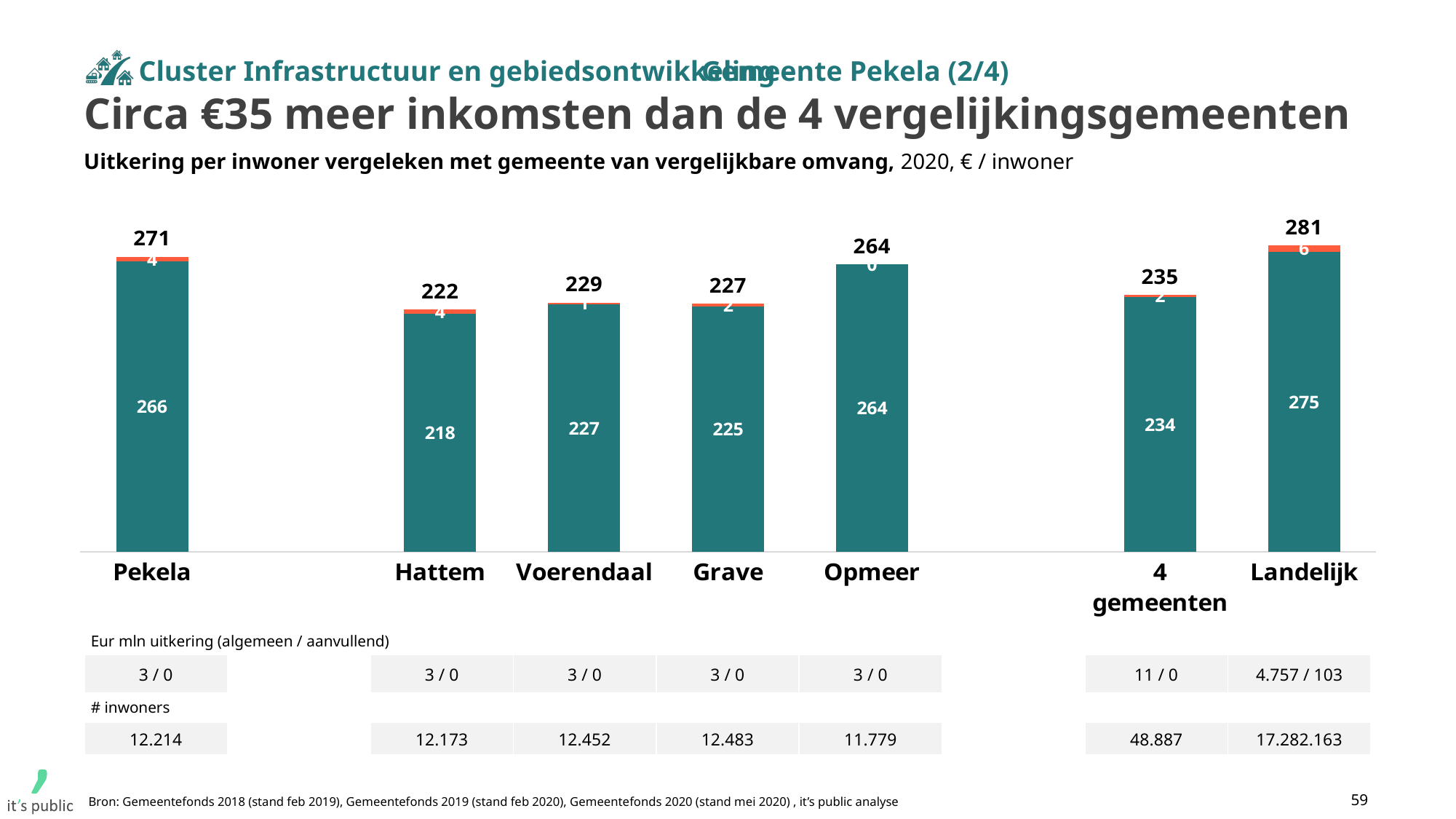
Which category has the lowest total bar? Hattem Which category has the highest total bar? Landelijk What is the total value of the bar for Pekela? 271 What kind of chart is shown on the slide? Stacked bar chart Which is larger, the total for Voerendaal or the total for Grave? Voerendaal What is the value of the orange (upper) segment for Landelijk? 6 What is the difference between the total for Pekela and the total for 4 gemeenten? 36 How many categories are shown on the x axis of the chart? 7 What is the subtitle of the chart? Uitkering per inwoner vergeleken met gemeente van vergelijkbare omvang, 2020, € / inwoner What is the total value of the bar for Landelijk? 281 What is the value of the teal (lower) segment for Opmeer? 264 What is the value of the teal (lower) segment for Hattem? 218